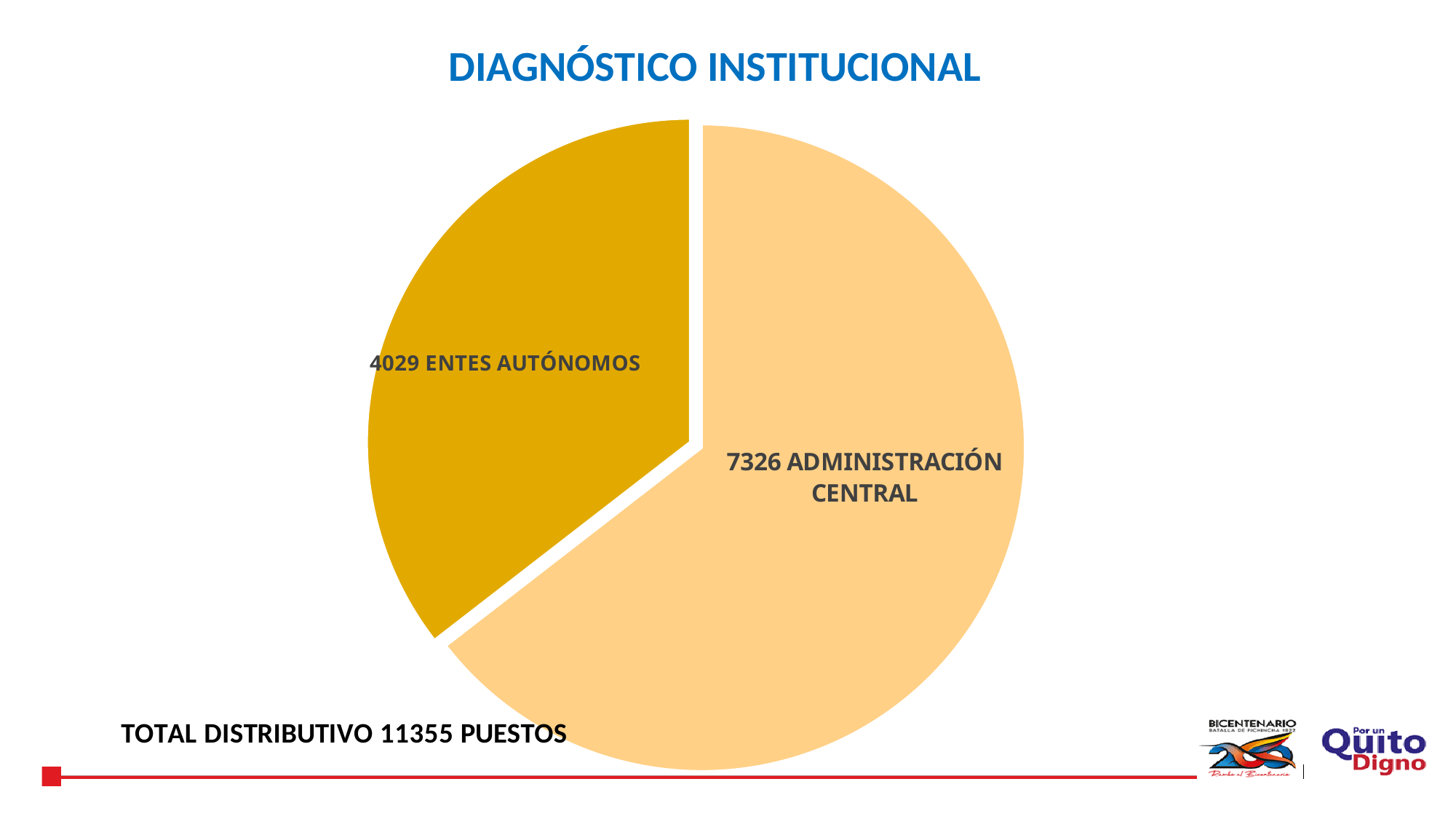
Which category has the largest slice of the pie? ADMINISTRACIÓN CENTRAL What kind of chart is shown on the slide? pie chart What is the difference between the values for ADMINISTRACIÓN CENTRAL and ENTES AUTÓNOMOS? 3297 How many slices does the pie chart have? 2 What is the total number of puestos stated on the slide? 11355 Which slice is drawn in the darker gold colour? ENTES AUTÓNOMOS What is the title of the slide containing the pie chart? DIAGNÓSTICO INSTITUCIONAL What is the value shown for ENTES AUTÓNOMOS? 4029 What is the value shown for ADMINISTRACIÓN CENTRAL? 7326 Which category has the smallest slice of the pie? ENTES AUTÓNOMOS What share of the total does ADMINISTRACIÓN CENTRAL represent, to one decimal place? 64.5% Which is larger, the value for ENTES AUTÓNOMOS or the value for ADMINISTRACIÓN CENTRAL? ADMINISTRACIÓN CENTRAL